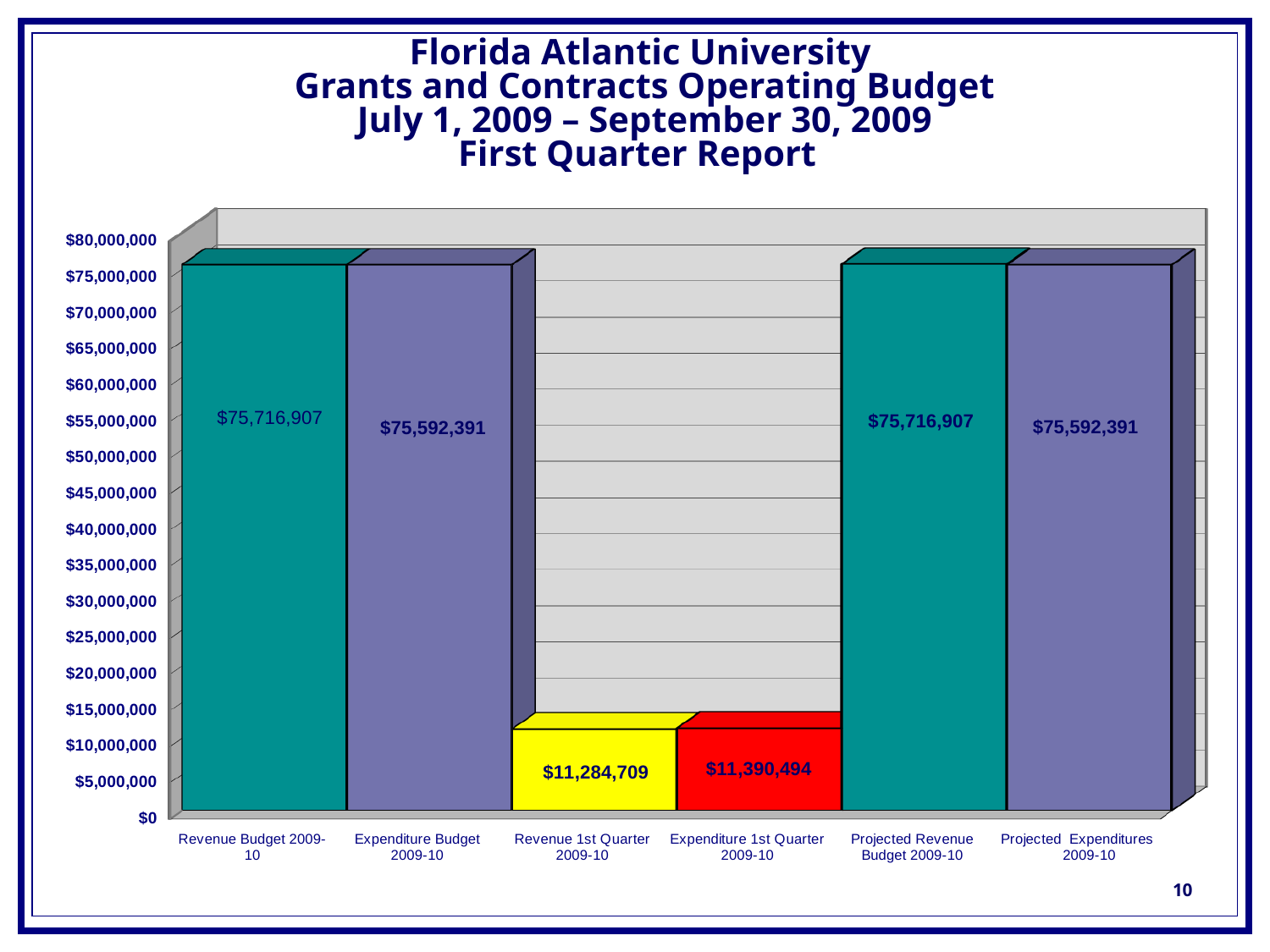
Is the value for Revenue 1st Quarter 2009-10 greater or less than $15,000,000? less Which category has the lowest value? Revenue 1st Quarter 2009-10 What is the value for Revenue Budget 2009-10? $75,716,907 What is the difference between Revenue Budget 2009-10 and Expenditure Budget 2009-10? $124,516 What is the value for Expenditure Budget 2009-10? $75,592,391 How many bars are shown in the chart? 6 What is the value for Revenue 1st Quarter 2009-10? $11,284,709 What kind of chart is shown on the slide? bar chart Which is larger, Revenue 1st Quarter 2009-10 or Expenditure 1st Quarter 2009-10? Expenditure 1st Quarter 2009-10 What is the value for Projected Expenditures 2009-10? $75,592,391 What is the value for Expenditure 1st Quarter 2009-10? $11,390,494 What is the difference between Expenditure 1st Quarter 2009-10 and Revenue 1st Quarter 2009-10? $105,785